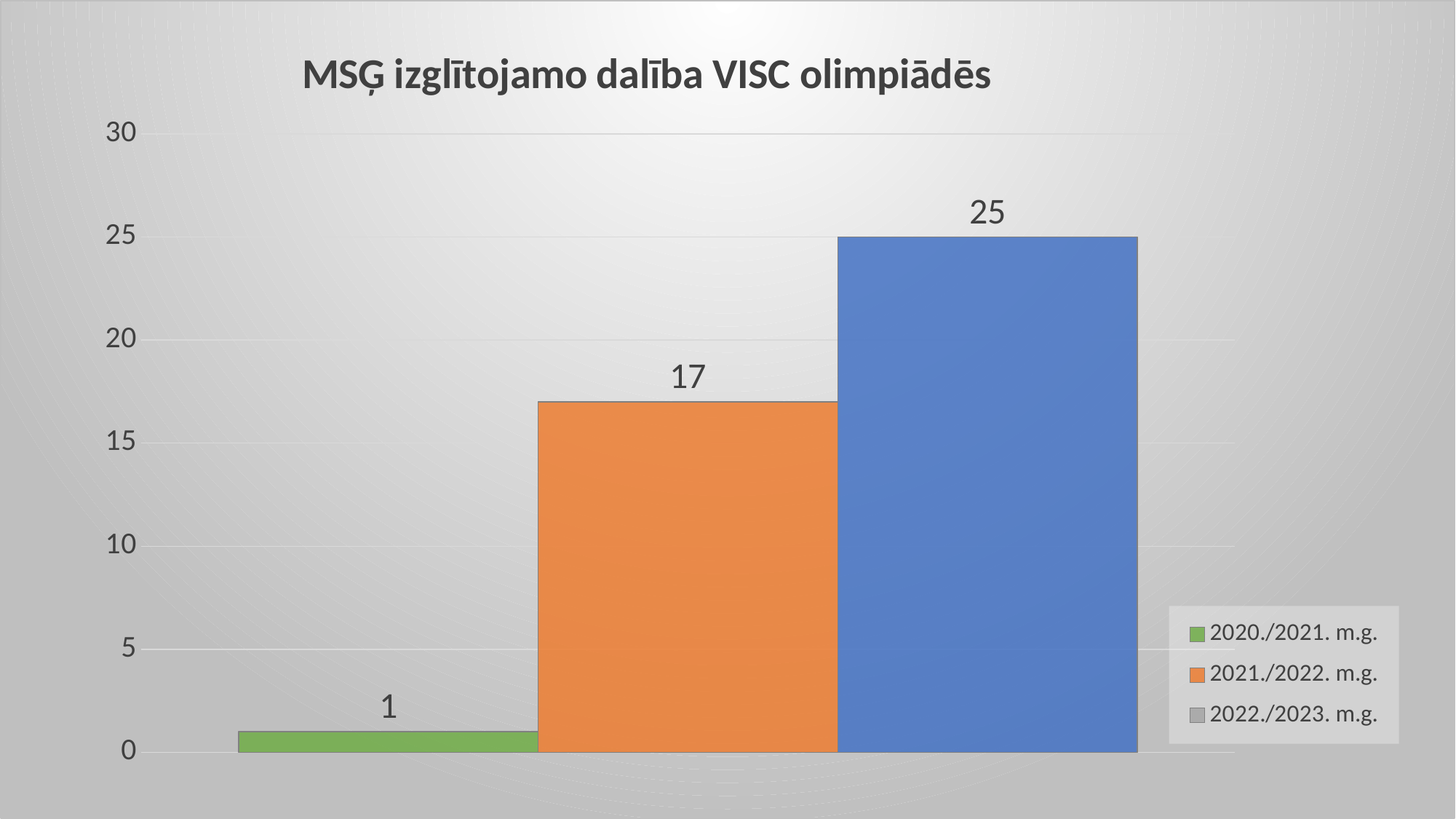
Which school year has the highest value? 2022./2023. m.g. What is the value for 2020./2021. m.g.? 1 How many series does the legend list? 3 Do the values rise or fall from 2020./2021. m.g. to 2022./2023. m.g.? rise What is the difference between the values for 2022./2023. m.g. and 2021./2022. m.g.? 8 Which is larger, the value for 2021./2022. m.g. or the value for 2020./2021. m.g.? 2021./2022. m.g. What is the value for 2022./2023. m.g.? 25 What is the title of the chart? MSĢ izglītojamo dalība VISC olimpiādēs Which school year has the lowest value? 2020./2021. m.g. Is the value for 2021./2022. m.g. greater or less than 20? less What kind of chart is shown on the slide? bar chart What is the value for 2021./2022. m.g.? 17